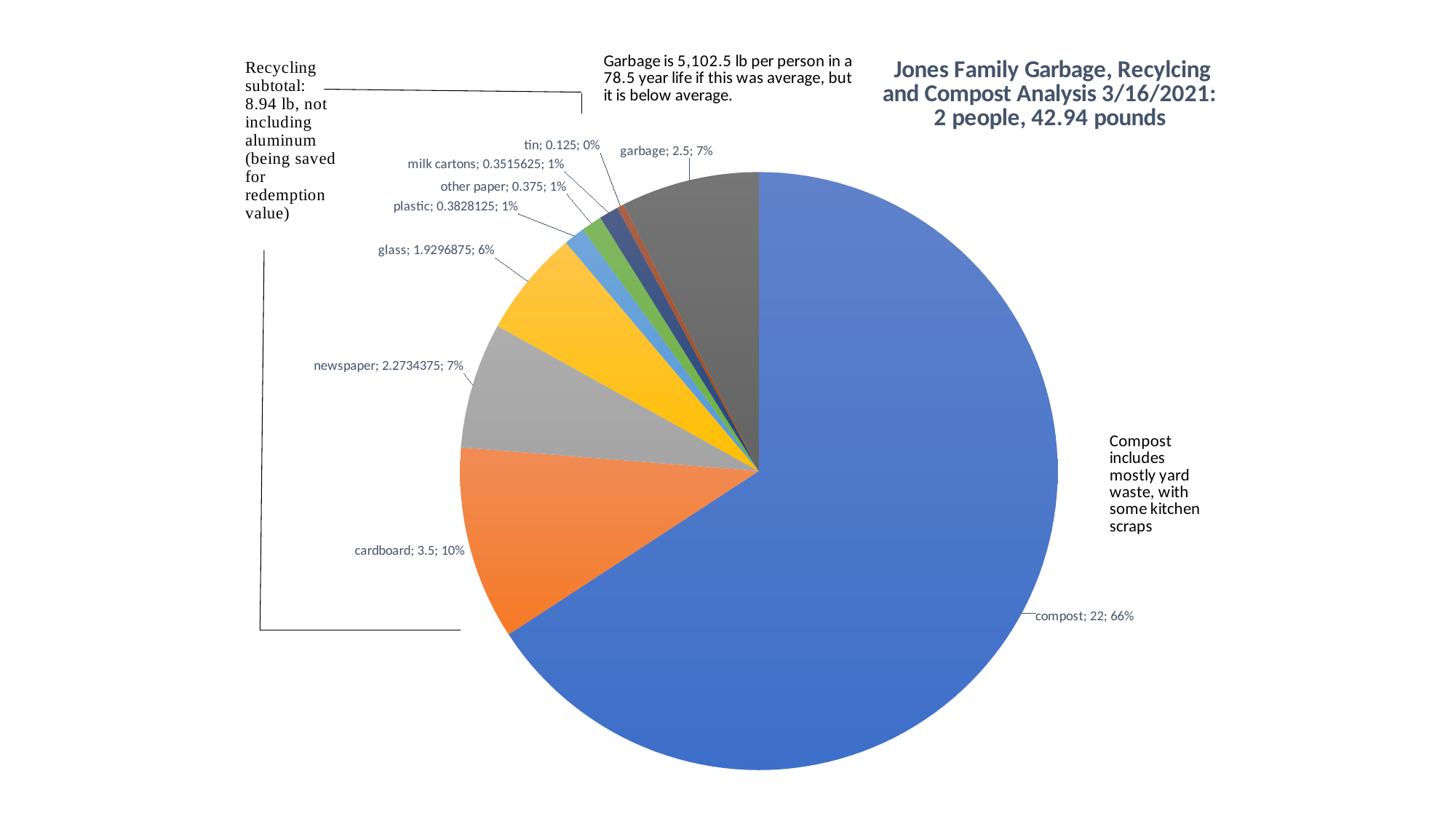
Which category has the largest slice of the pie? compost Which category has the smallest slice of the pie? tin What is the value shown for cardboard? 3.5 What percentage share of the pie does glass have? 6% Which is larger, the value for cardboard or the value for garbage? cardboard What is the difference between the values for compost and cardboard? 18.5 What is the value shown for newspaper? 2.2734375 What percentage share of the pie does compost have? 66% What type of chart is shown on the slide? pie chart How many categories are shown in the pie chart? 9 What is the value shown for compost? 22 What is the value shown for garbage? 2.5